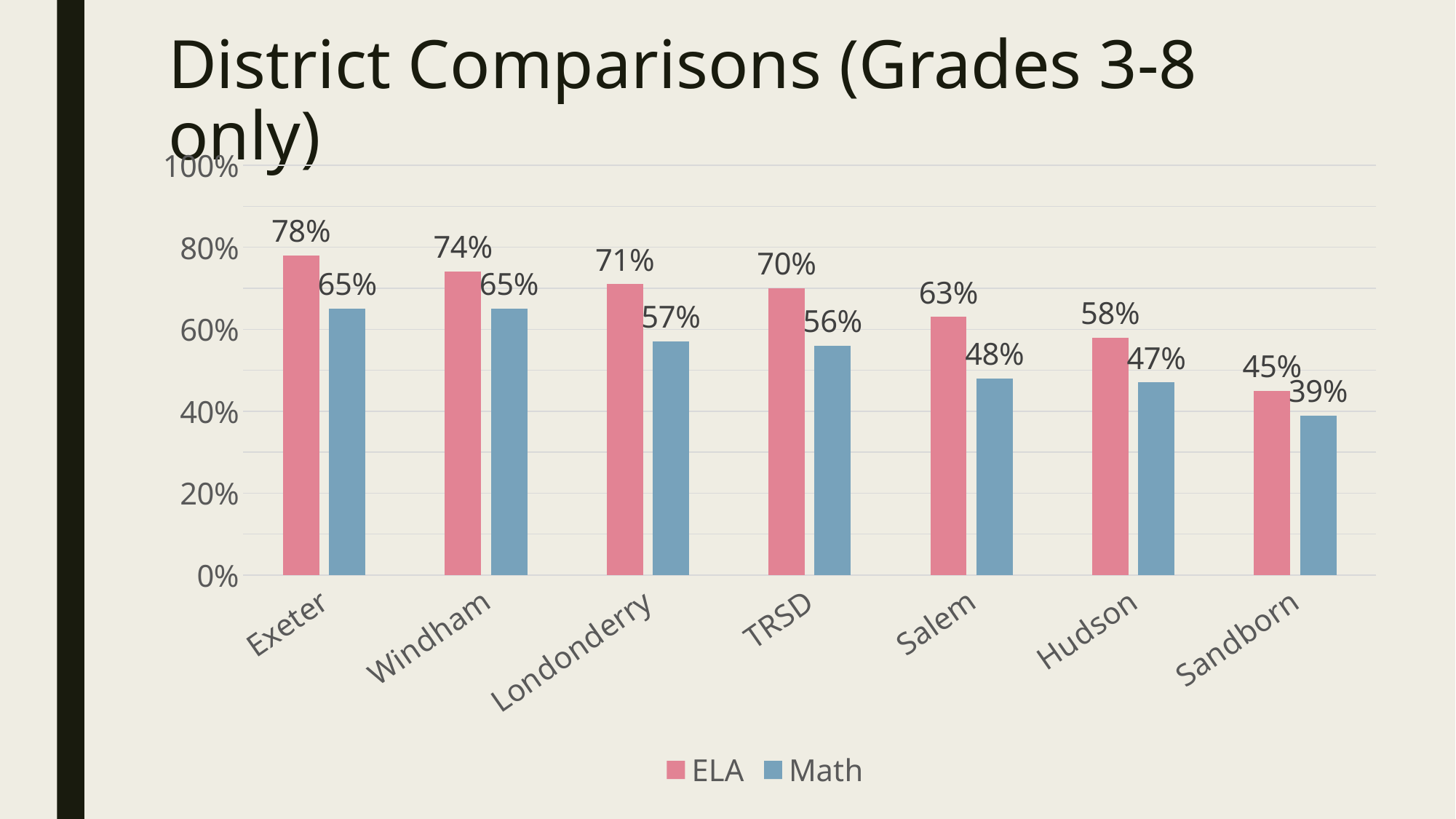
Which district has the highest ELA value? Exeter What is the difference between the ELA and Math values for Salem? 15% What is the Math value for Sandborn? 39% How many series does the legend list? 2 What kind of chart is shown on the slide? bar chart How many districts are shown on the x axis? 7 Do the ELA values rise or fall from Exeter to Sandborn along the x axis? fall What is the Math value for Londonderry? 57% Which is larger, the Math value for TRSD or the Math value for Hudson? TRSD Which district has the lowest Math value? Sandborn What is the ELA value for Exeter? 78% Is the ELA value for Hudson greater or less than 60%? less